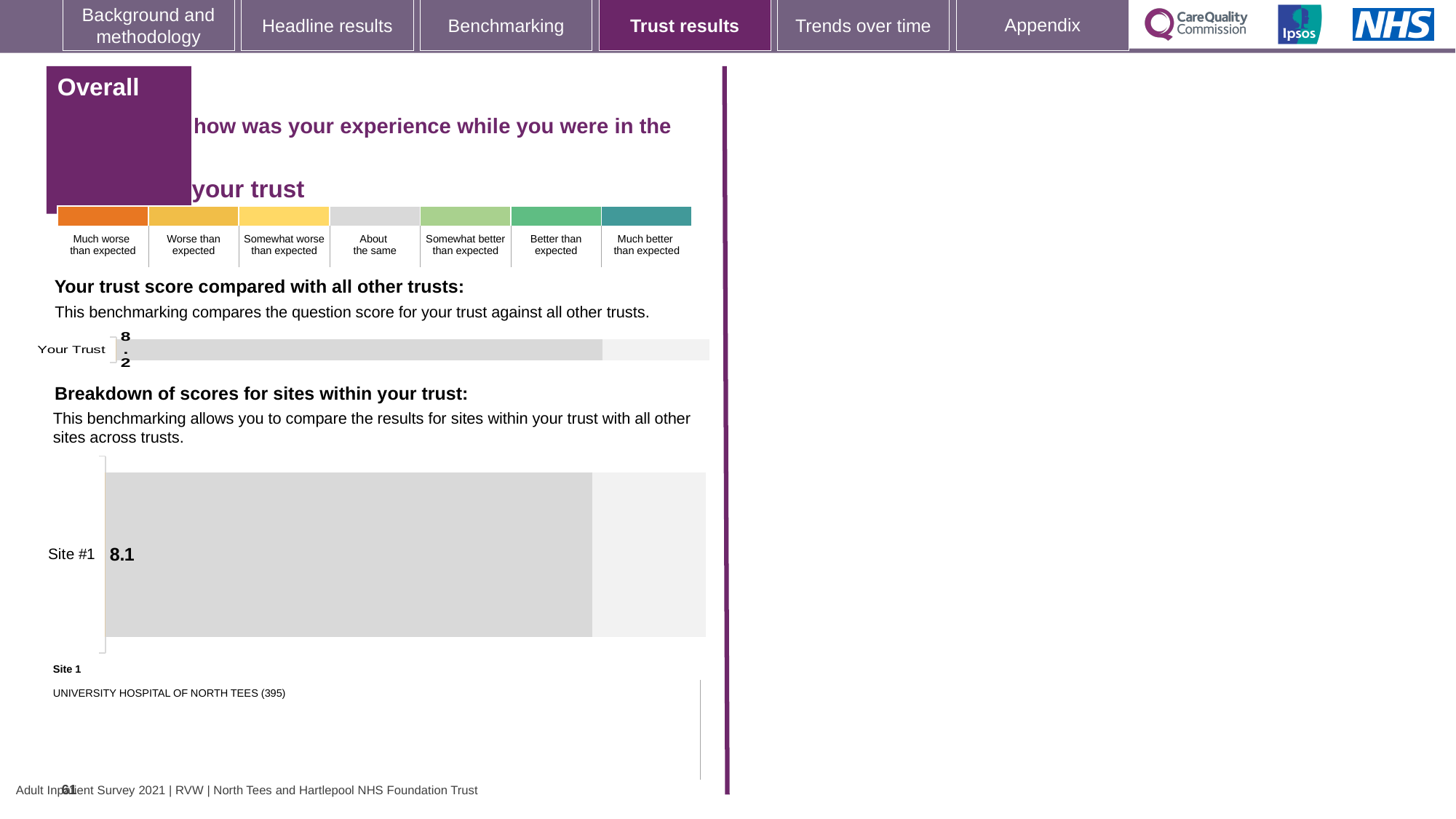
What kind of chart is used in the 'Your trust score compared with all other trusts' section? bar chart How many bars are plotted in the 'Your trust score compared with all other trusts' chart? 1 What is the difference between the Your Trust score (8.2) in the top chart and the Site #1 score (8.1) in the bottom chart? 0.1 What kind of chart is used in the 'Breakdown of scores for sites within your trust' section? bar chart Which hospital is listed as Site 1 below the 'Breakdown of scores for sites within your trust' chart? UNIVERSITY HOSPITAL OF NORTH TEES (395) In the 'Your trust score compared with all other trusts' chart, what is the score for Your Trust? 8.2 How many rating categories are shown in the colour key above the charts, from 'Much worse than expected' to 'Much better than expected'? 7 Which is larger: the Your Trust score in the top chart or the Site #1 score in the bottom chart? Your Trust In the 'Breakdown of scores for sites within your trust' chart, what is the score for Site #1? 8.1 How many sites are shown in the 'Breakdown of scores for sites within your trust' chart? 1